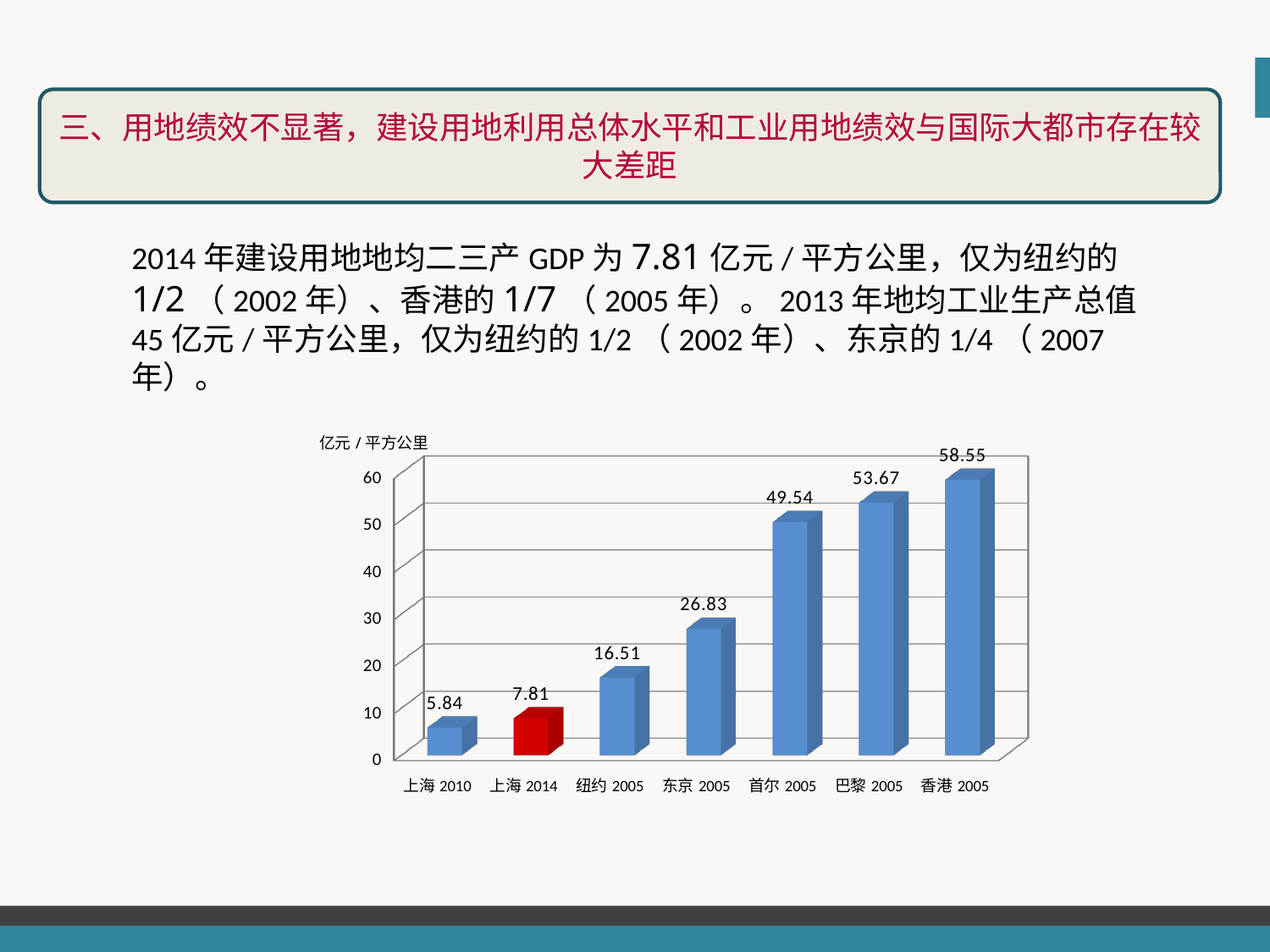
Which is larger, the value for 首尔 2005 or the value for 巴黎 2005? 巴黎 2005 What is the value for 上海 2014? 7.81 Which category has the highest value? 香港 2005 What unit label is shown above the vertical axis of the chart? 亿元 / 平方公里 What is the value for 东京 2005? 26.83 What is the difference between the values for 香港 2005 and 上海 2014? 50.74 What kind of chart is shown on the slide? bar chart What is the value for 纽约 2005? 16.51 Is the value for 首尔 2005 greater or less than 40? greater How many categories are shown on the x axis? 7 What is the difference between the values for 上海 2014 and 上海 2010? 1.97 Which category has the lowest value? 上海 2010